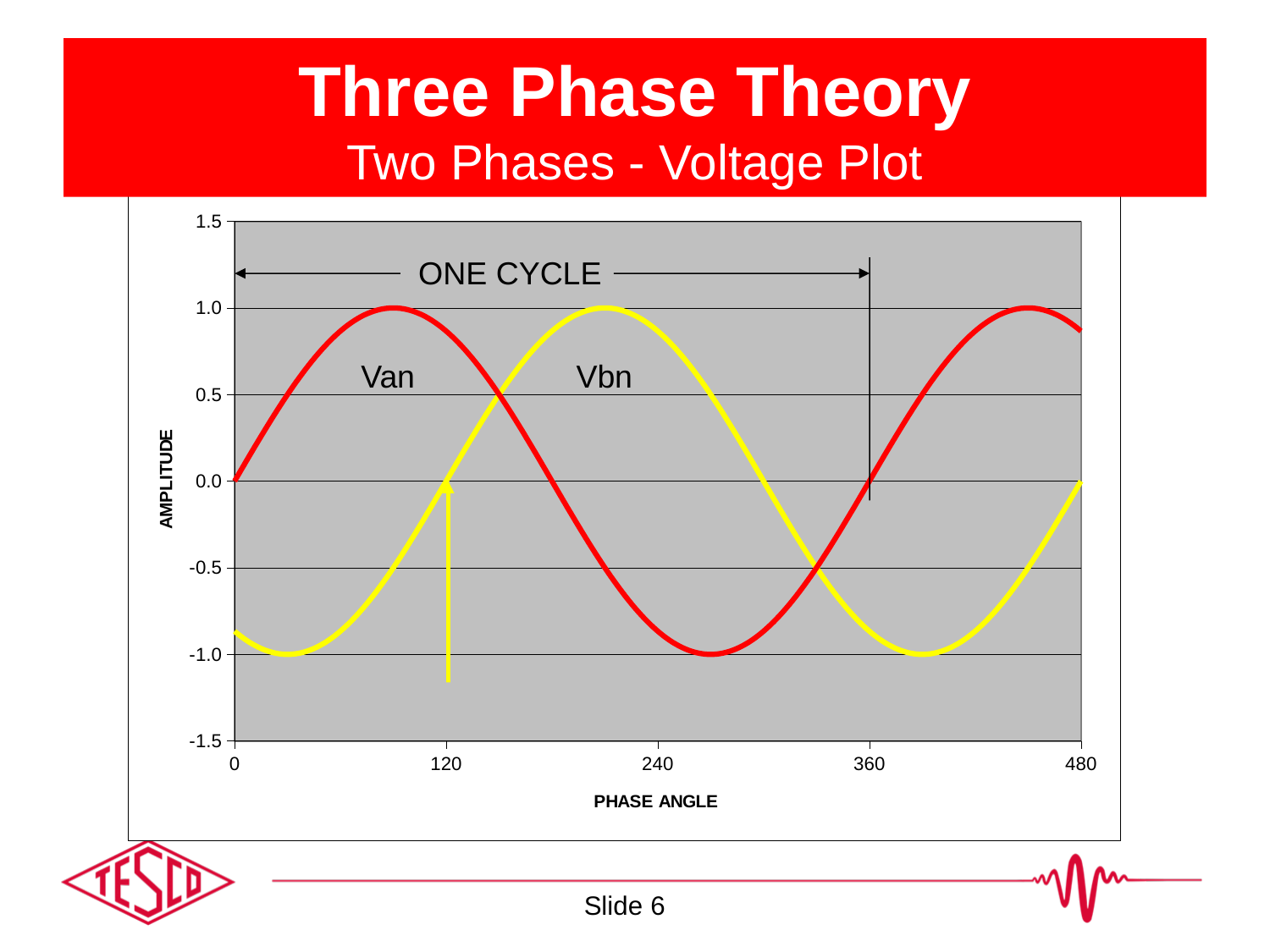
What is the amplitude of Vbn at a phase angle of 120? 0.0 Which waveform is drawn in yellow? Vbn What is the label of the x axis of the chart? PHASE ANGLE At a phase angle of 240, which waveform has the larger amplitude, Van or Vbn? Vbn Is the amplitude of Vbn at a phase angle of 0 greater or less than -0.5? less Is the amplitude of Van at a phase angle of 120 greater or less than 0.5? greater What is the amplitude of Van at a phase angle of 0? 0.0 How many waveforms are plotted on the chart? 2 What kind of chart is shown on the slide? line chart Between phase angles 120 and 240, does the amplitude of Van rise or fall? fall What is the peak amplitude reached by Van? 1.0 What is the lowest amplitude reached by Vbn? -1.0